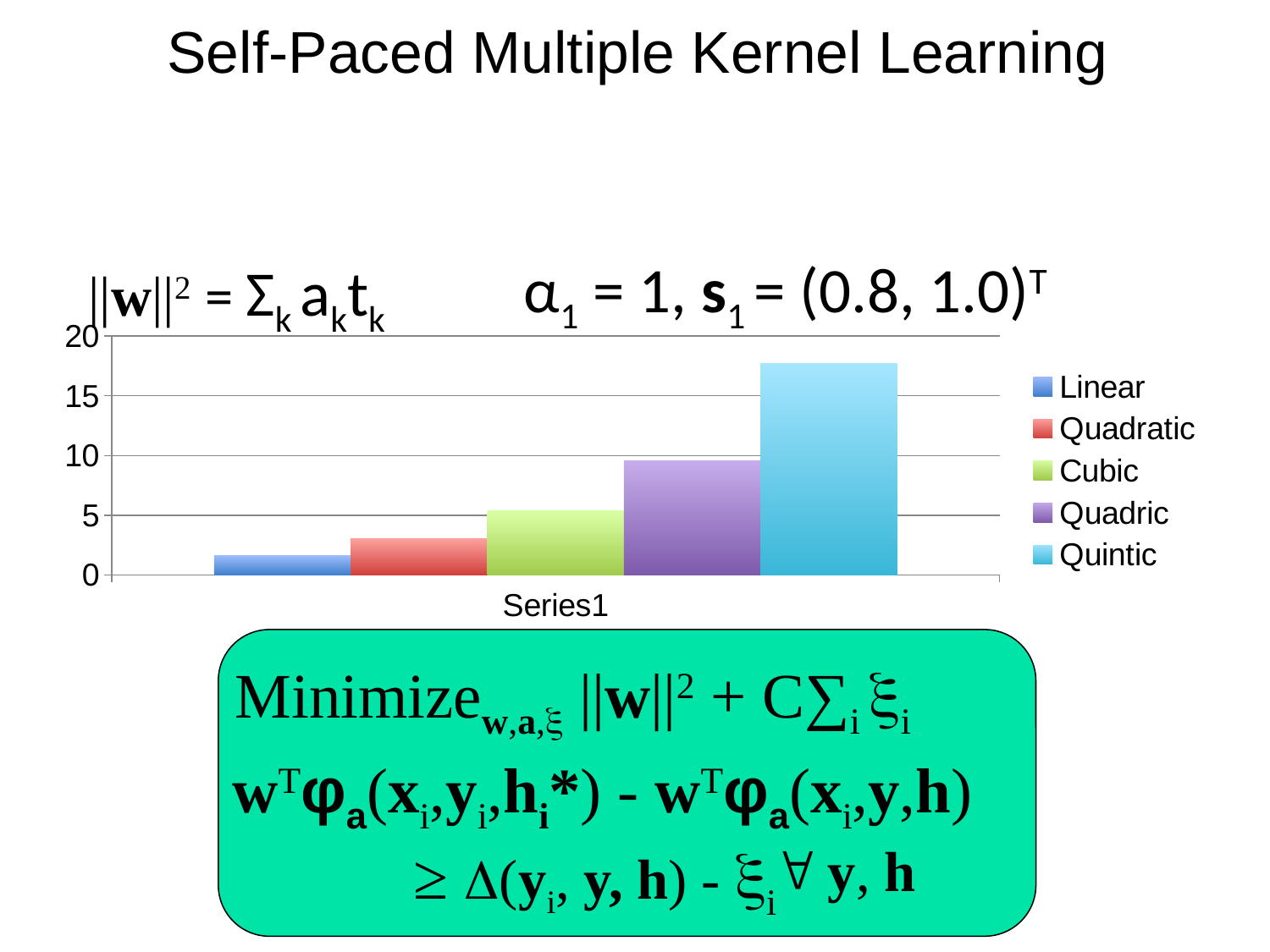
Which is larger, the Quadric bar or the Cubic bar? Quadric Is the value for Quintic greater or less than 15? greater What kind of chart is shown on the slide? bar chart Which series has the shortest bar? Linear How many series does the legend list? 5 Do the bars rise or fall going from Linear to Quintic? rise What colour is the Quintic bar in the legend? light blue Is the value for Linear greater or less than 5? less Which series has the tallest bar? Quintic Which is larger, the Linear bar or the Quadratic bar? Quadratic